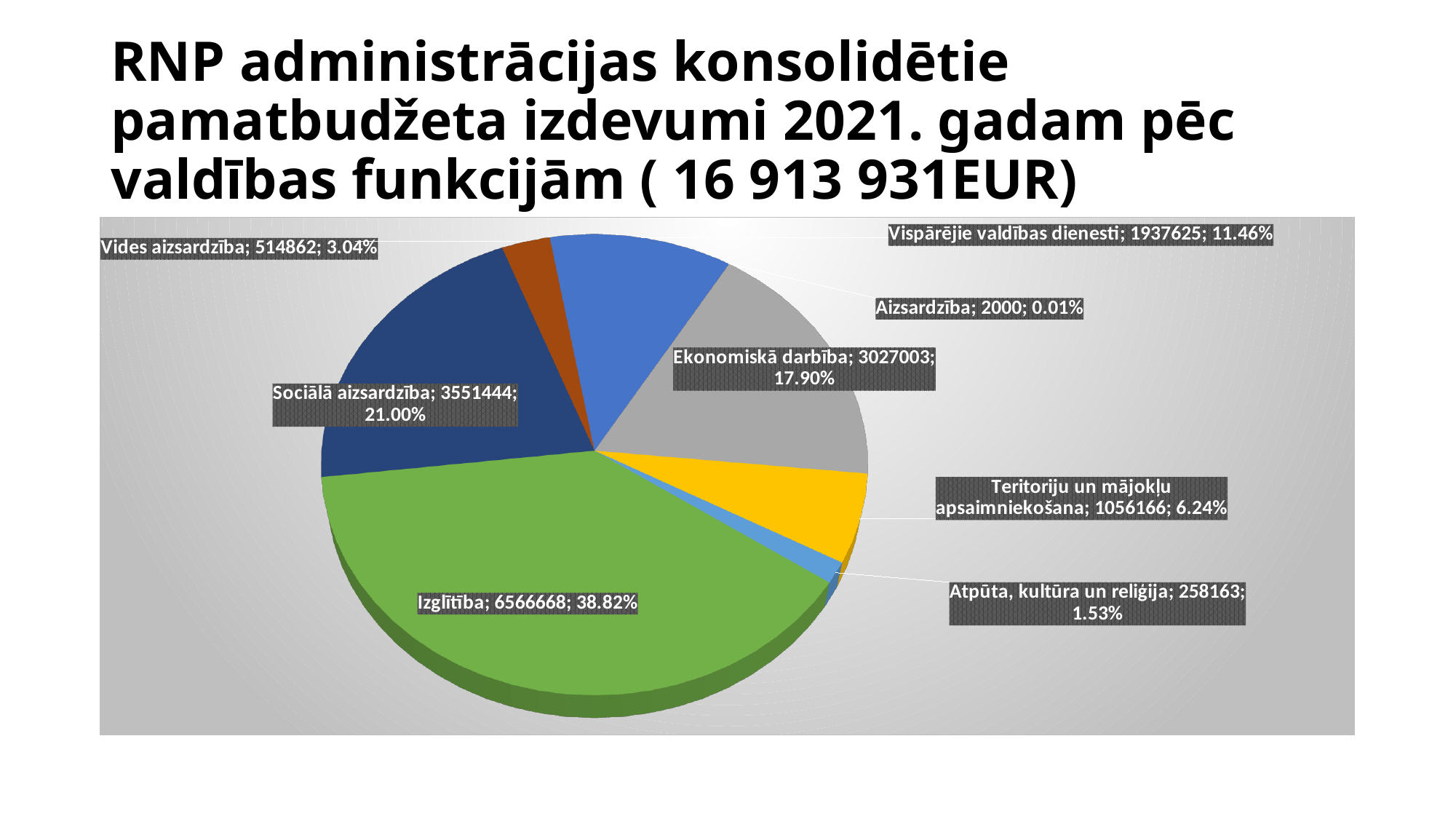
What percentage share does Teritoriju un mājokļu apsaimniekošana have? 6.24% How many categories (slices) does the pie chart have? 8 What total amount in EUR is stated in the slide title? 16 913 931EUR Which category has the smallest slice of the pie? Aizsardzība What is the value shown for Izglītība? 6566668 What is the value shown for Atpūta, kultūra un reliģija? 258163 What is the difference between the values for Sociālā aizsardzība and Ekonomiskā darbība? 524441 What percentage share does Sociālā aizsardzība have? 21.00% What is the value shown for Ekonomiskā darbība? 3027003 What type of chart is shown on the slide? Pie chart Which is larger, the value for Vispārējie valdības dienesti or the value for Vides aizsardzība? Vispārējie valdības dienesti Which category has the largest slice of the pie? Izglītība